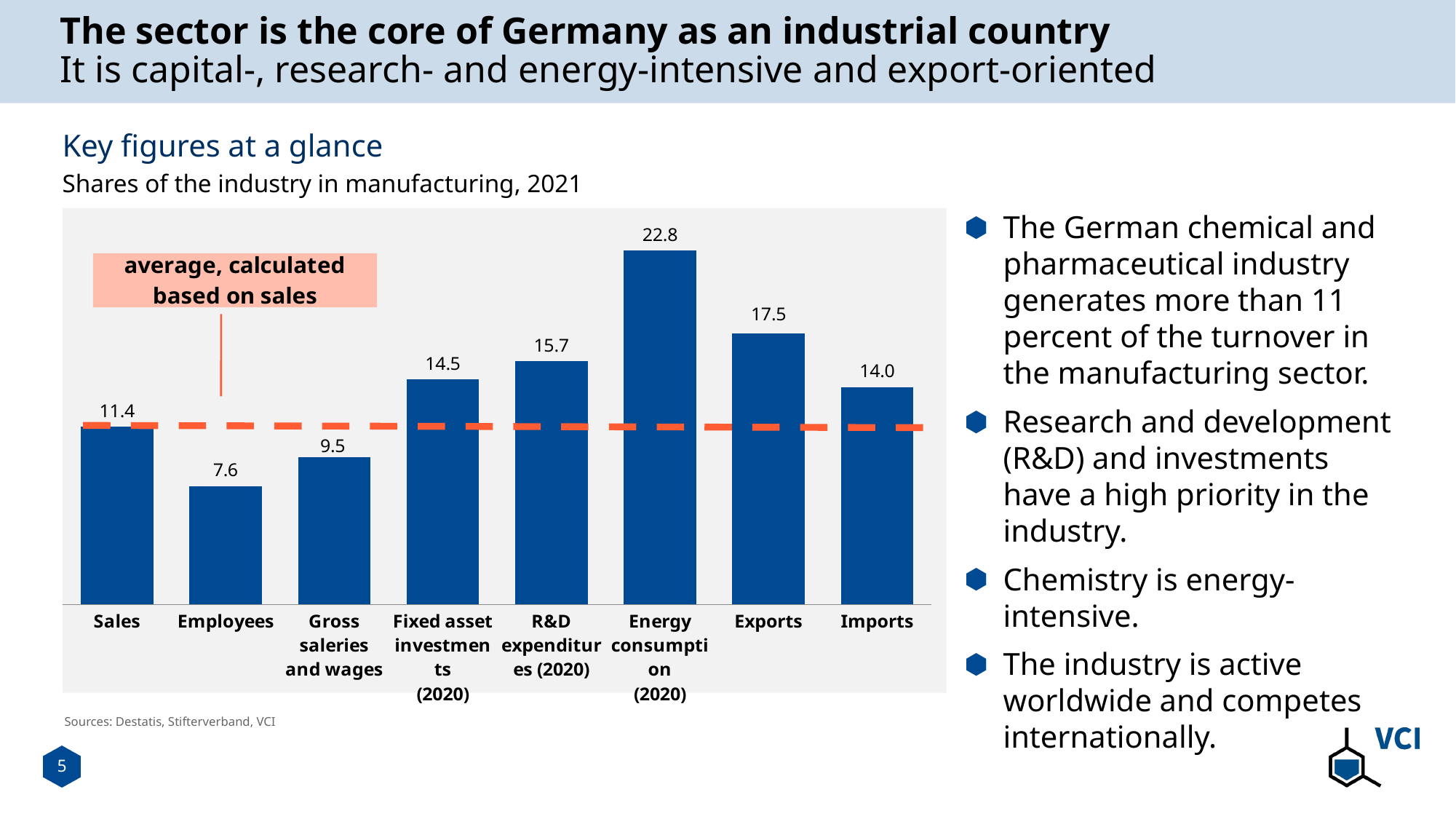
What is the value for Energy consumption (2020)? 22.8 Which category has the lowest value? Employees What is the difference between the values for Exports and Imports? 3.5 How many categories are shown in the chart? 8 What is the value for Exports? 17.5 What is the value for Sales? 11.4 What kind of chart is shown on the slide? Bar chart What is the difference between the values for R&D expenditures (2020) and Fixed asset investments (2020)? 1.2 Which is larger, the value for Gross salaries and wages or the value for Sales? Sales What does the dashed horizontal line in the chart represent? Average, calculated based on sales Which category has the highest value? Energy consumption (2020) What is the value for Employees? 7.6